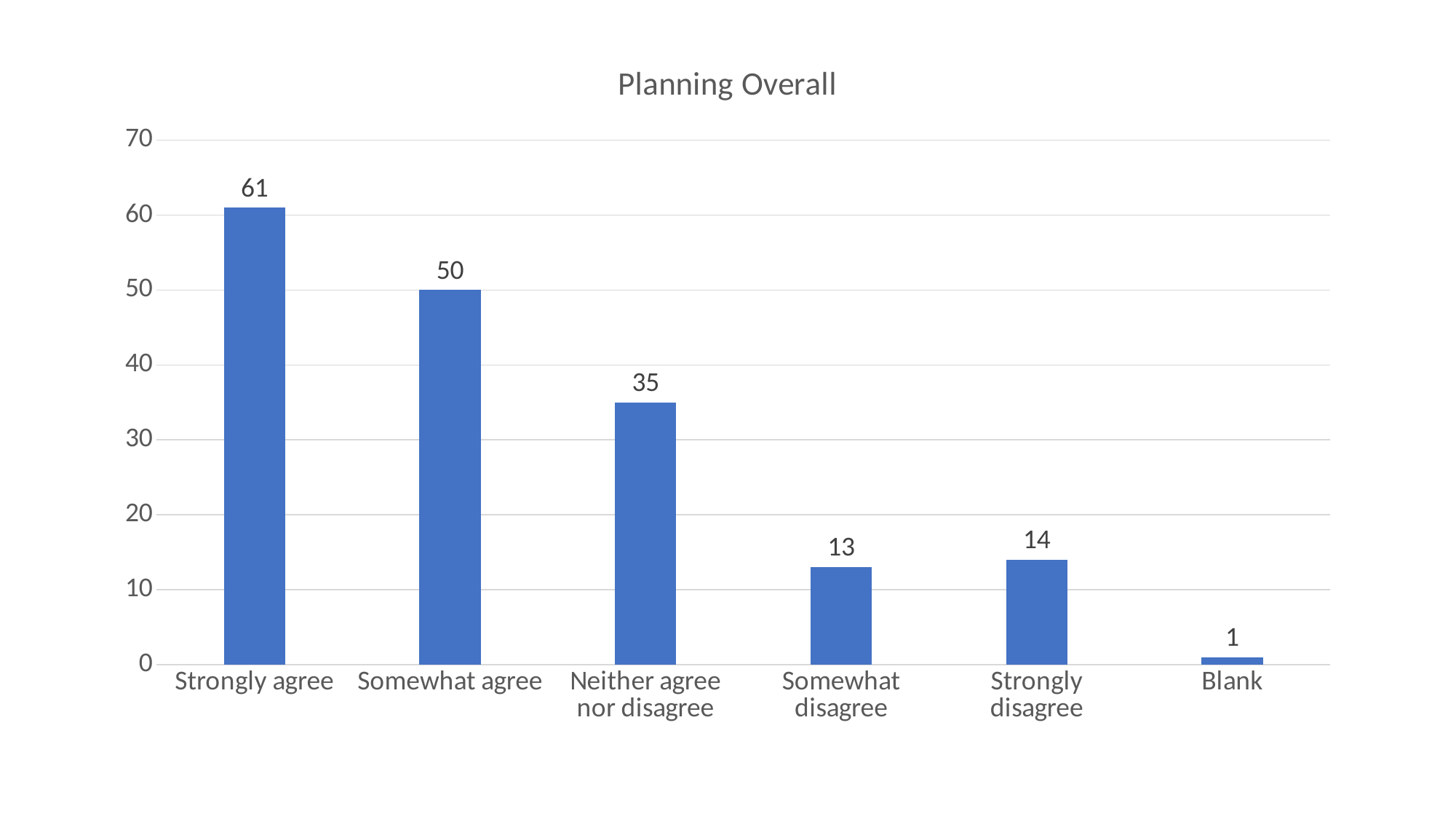
What is the value for Strongly agree? 61 Which category has the highest value? Strongly agree Is the value for Somewhat disagree greater or less than 20? less Which is larger, Somewhat agree or Neither agree nor disagree? Somewhat agree How many categories are shown on the x axis? 6 Which category has the lowest value? Blank What is the title of the chart? Planning Overall What is the value for Neither agree nor disagree? 35 What is the value for Blank? 1 What is the difference between Strongly disagree and Somewhat disagree? 1 What kind of chart is this? bar chart What is the difference between Strongly agree and Somewhat agree? 11